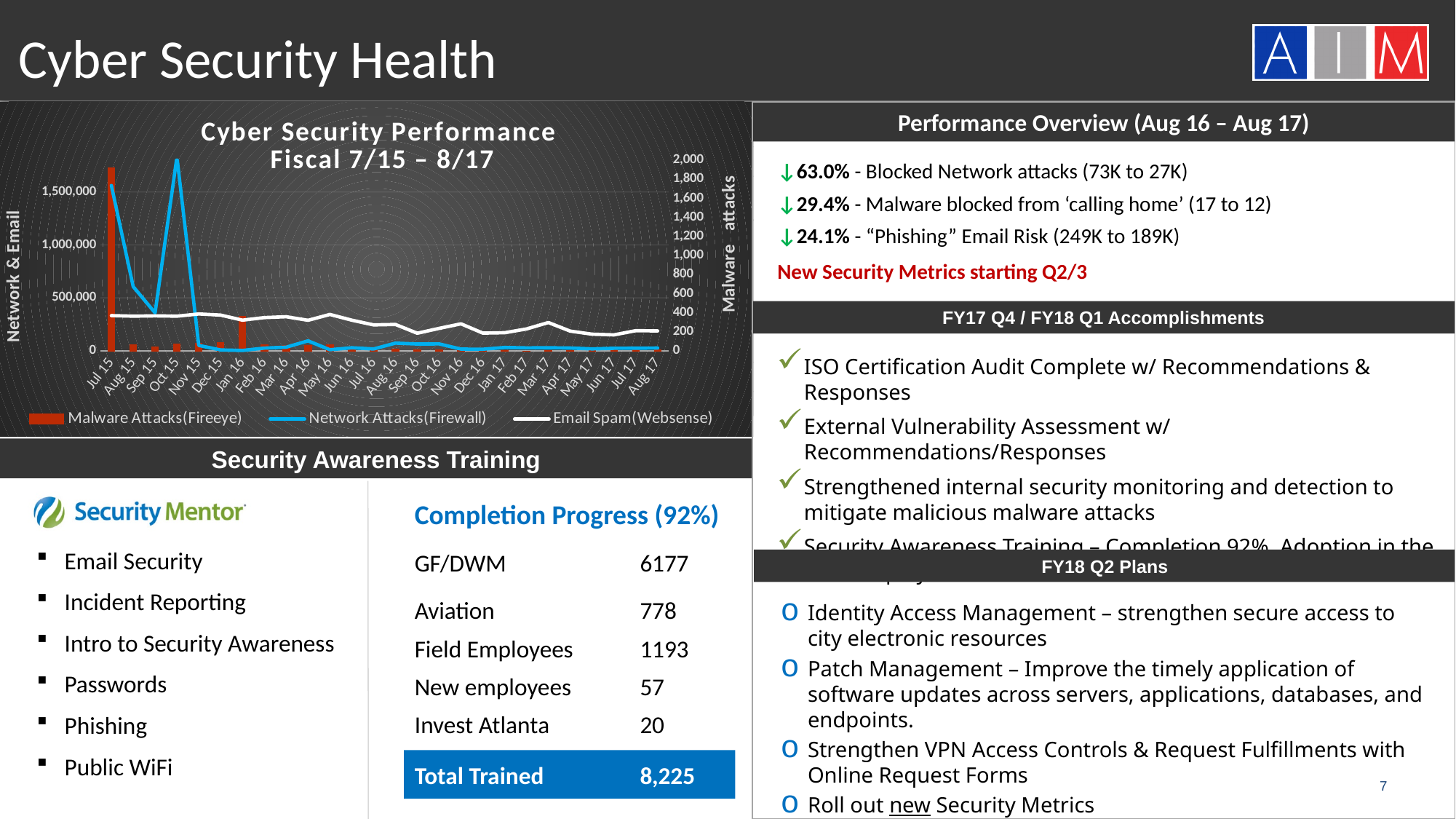
How many series does the legend of the Cyber Security Performance chart list? 3 Which is larger, the Network Attacks (Firewall) value for Jul 15 or for Oct 15? Oct 15 In which month is the Malware Attacks (Fireeye) bar the tallest? Jul 15 Is the Email Spam (Websense) value for Jul 15 greater or less than 500,000? less What is the label of the right-hand vertical axis of the chart? Malware attacks In which month does the Network Attacks (Firewall) series reach its highest value? Oct 15 What kind of chart is the Cyber Security Performance chart? Combination bar and line chart How many months are plotted along the x axis of the Cyber Security Performance chart? 26 Is the Network Attacks (Firewall) value for Oct 15 greater or less than 1,500,000? greater Does the Email Spam (Websense) series generally rise or fall from Jul 15 to Aug 17? fall Is the Network Attacks (Firewall) value for Aug 17 greater or less than 500,000? less What colour is the Network Attacks (Firewall) line in the chart? Blue